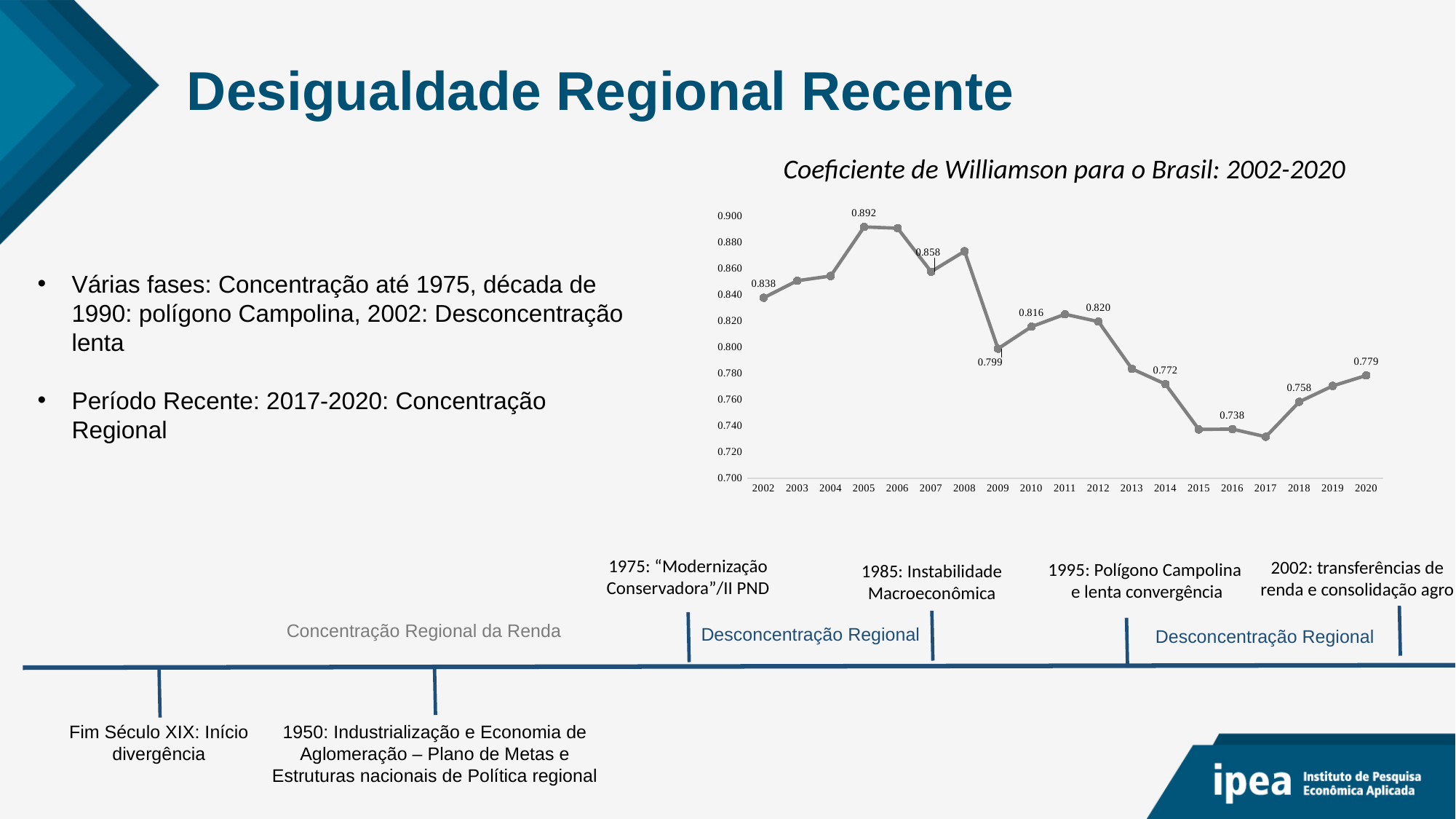
What is the title of the chart? Coeficiente de Williamson para o Brasil: 2002-2020 What is the value of the Williamson coefficient for 2020? 0.779 How many years are plotted on the x axis of the chart? 19 Do the values rise or fall from 2012 to 2017? fall Is the value for 2019 greater or less than 0.780? less Is the value for 2008 greater or less than 0.860? greater What is the value of the Williamson coefficient for 2002? 0.838 What is the value of the Williamson coefficient for 2016? 0.738 What is the difference between the values for 2005 and 2002? 0.054 Which year has the larger value, 2010 or 2012? 2012 What type of chart is shown on the slide? line chart What is the value of the Williamson coefficient for 2005? 0.892